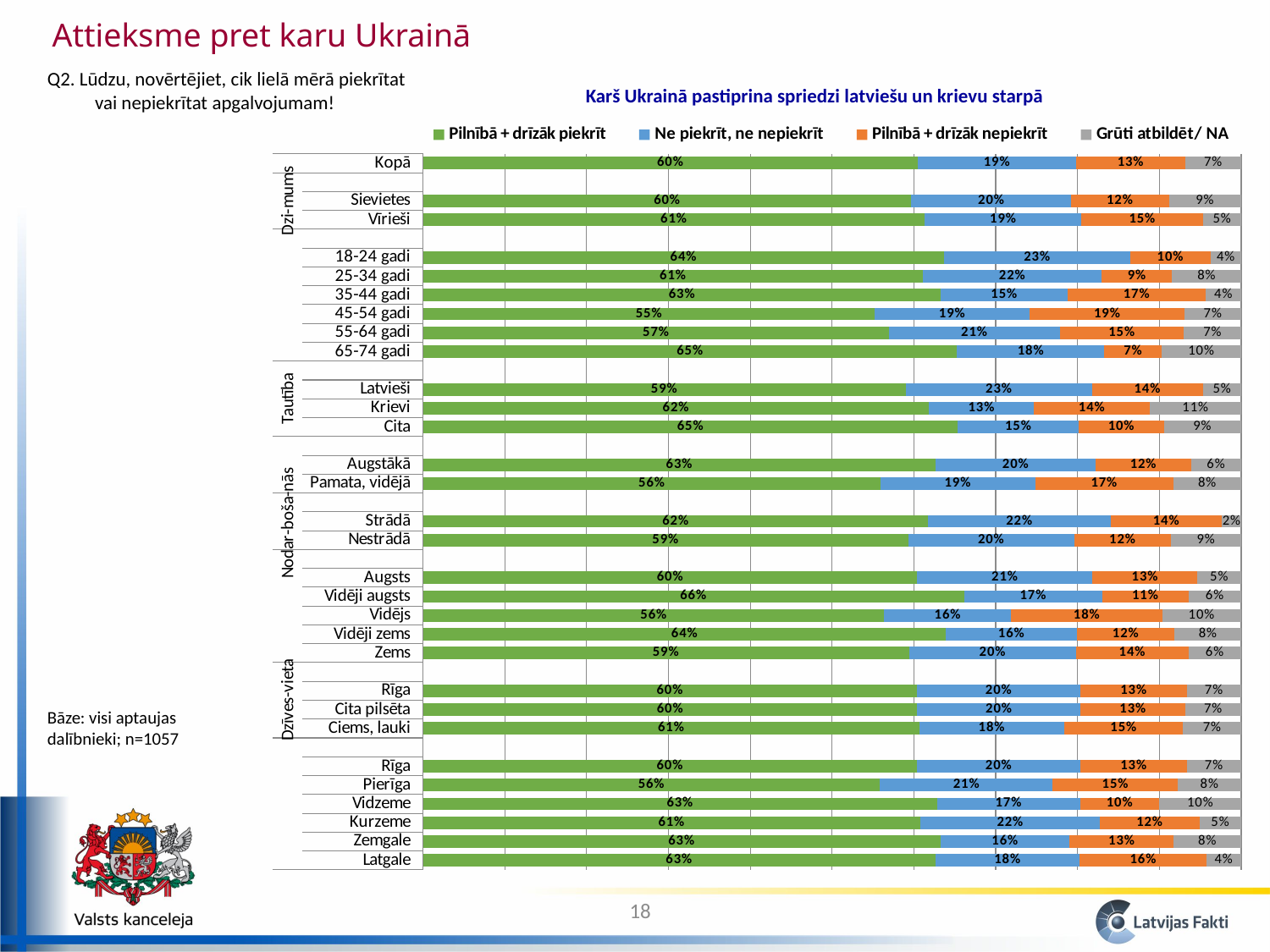
How many series does the legend list? 4 What percentage of the 'Kopā' group falls in the 'Pilnībā + drīzāk piekrīt' category? 60% What is the 'Ne piekrīt, ne nepiekrīt' value for '18-24 gadi'? 23% What is the title of the chart? Karš Ukrainā pastiprina spriedzi latviešu un krievu starpā What is the 'Grūti atbildēt/ NA' value for 'Krievi'? 11% Which colour represents the 'Grūti atbildēt/ NA' series? Grey What is the total of the 'Pilnībā + drīzāk piekrīt' and 'Ne piekrīt, ne nepiekrīt' values for 'Strādā'? 84% Which category has the lowest 'Pilnībā + drīzāk piekrīt' value? 45-54 gadi Which has a larger 'Pilnībā + drīzāk piekrīt' value, 'Latvieši' or 'Krievi'? Krievi What kind of chart is shown on the slide? Stacked bar chart What is the difference between the 'Pilnībā + drīzāk nepiekrīt' values for '35-44 gadi' and '65-74 gadi'? 10% Which category has the highest 'Pilnībā + drīzāk piekrīt' value? Vidēji augsts